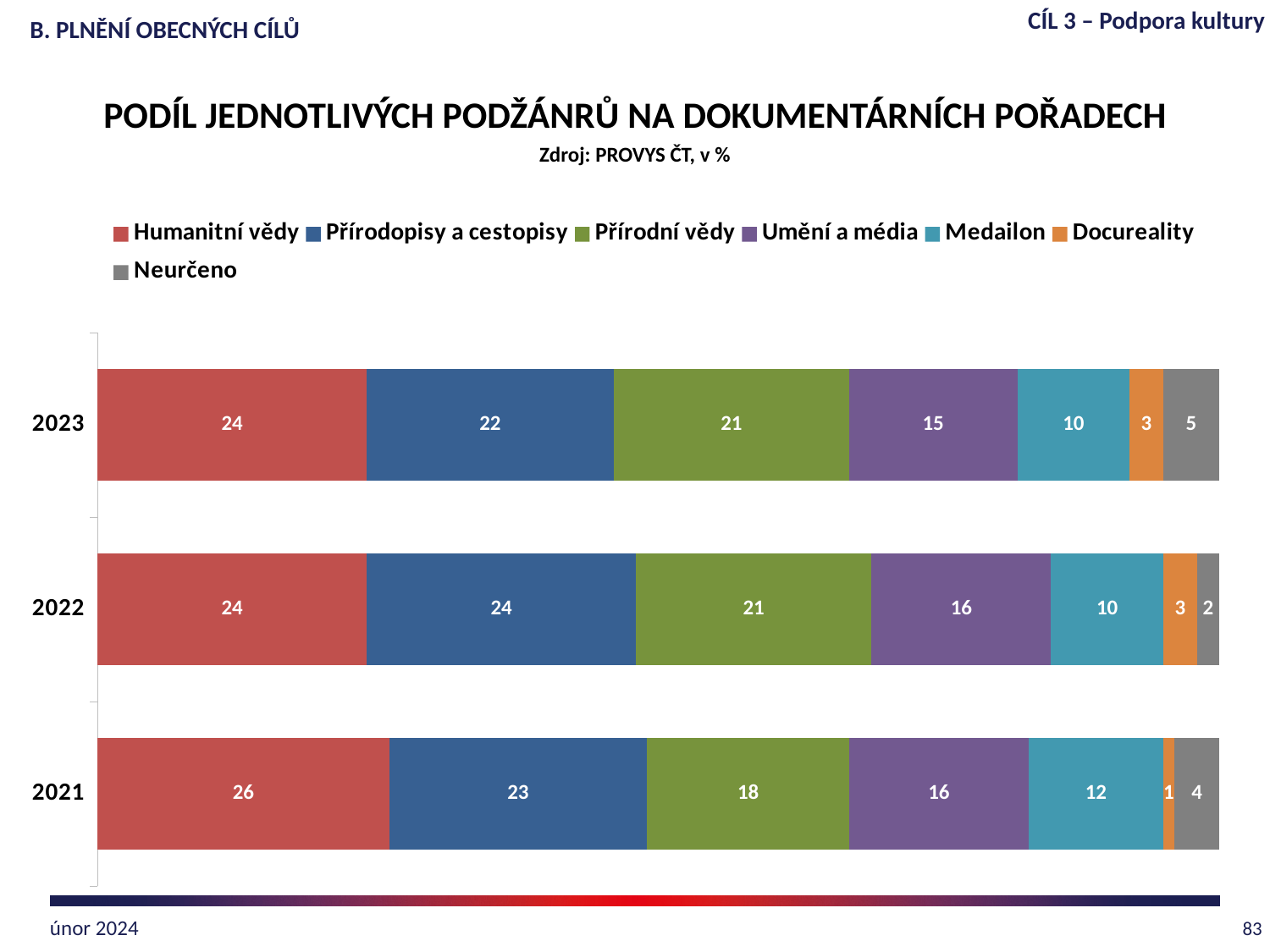
How many years are shown on the chart? 3 What is the total of the stacked bar for 2022? 100 What is the value for Docureality in 2021? 1 What is the value for Neurčeno in 2022? 2 Which subgenre has the lowest share in 2021? Docureality What is the difference between Přírodní vědy in 2023 and Přírodní vědy in 2021? 3 What is the value for Humanitní vědy in 2021? 26 What kind of chart is shown on the slide? Stacked bar chart Which is larger: Umění a média in 2022 or Umění a média in 2023? Umění a média in 2022 How many series does the legend list? 7 What is the value for Medailon in 2023? 10 Which subgenre has the highest share in 2023? Humanitní vědy